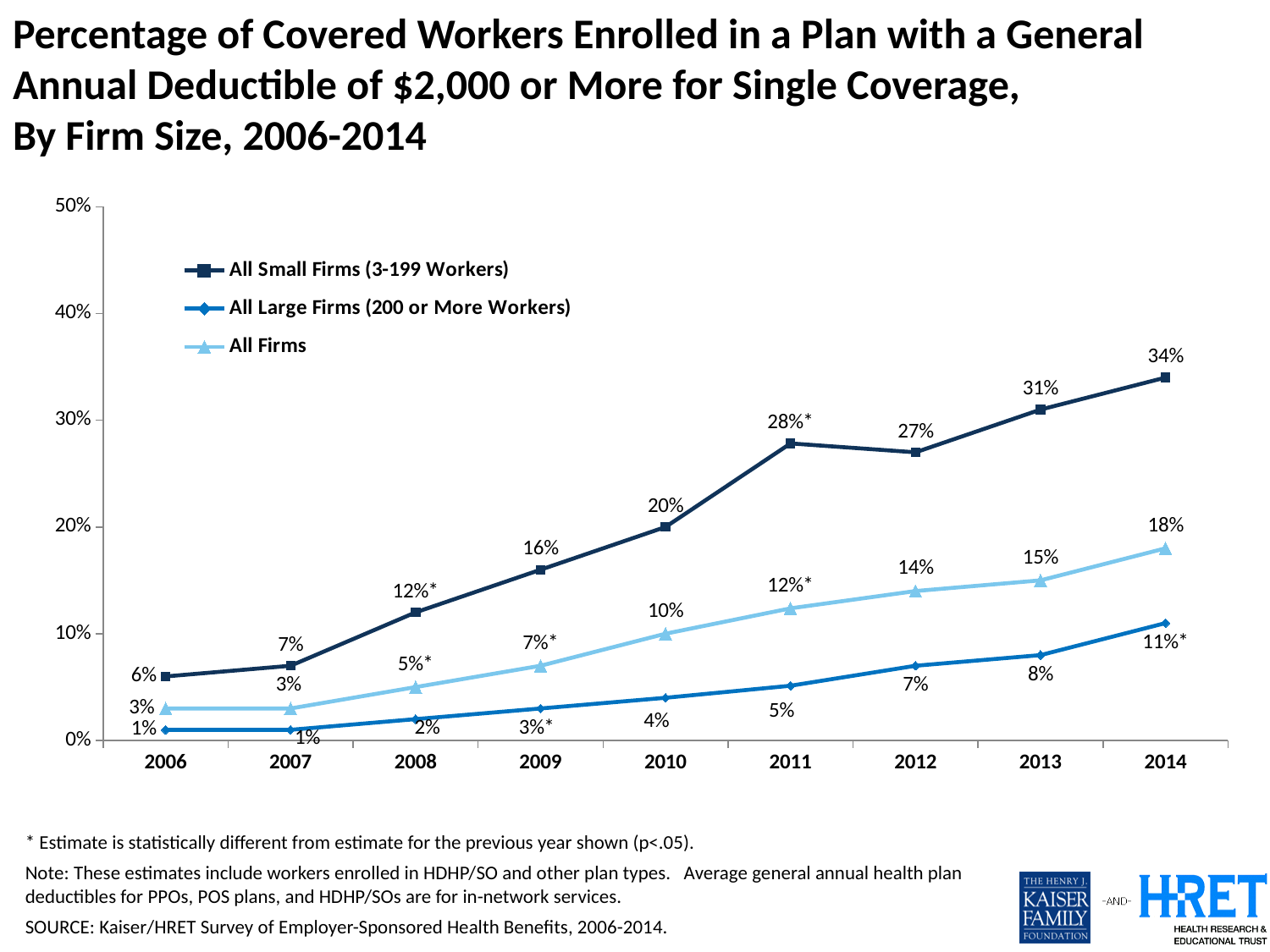
What is the value for All Small Firms (3-199 Workers) in 2014? 34% In which year is the value for All Firms lowest? 2006 and 2007 How many years are plotted along the x axis? 9 What is the value for All Large Firms (200 or More Workers) in 2013? 8% How many series does the legend list? 3 What is the difference between the All Small Firms value and the All Large Firms value in 2012? 20% What type of chart is shown on the slide? line chart Is the value for All Small Firms (3-199 Workers) in 2011 greater or less than 20%? greater Which is larger in 2013: the value for All Firms or the value for All Large Firms (200 or More Workers)? All Firms In which year is the value for All Small Firms (3-199 Workers) highest? 2014 What is the value for All Firms in 2010? 10% Does the value for All Firms rise or fall from 2006 to 2014? rise